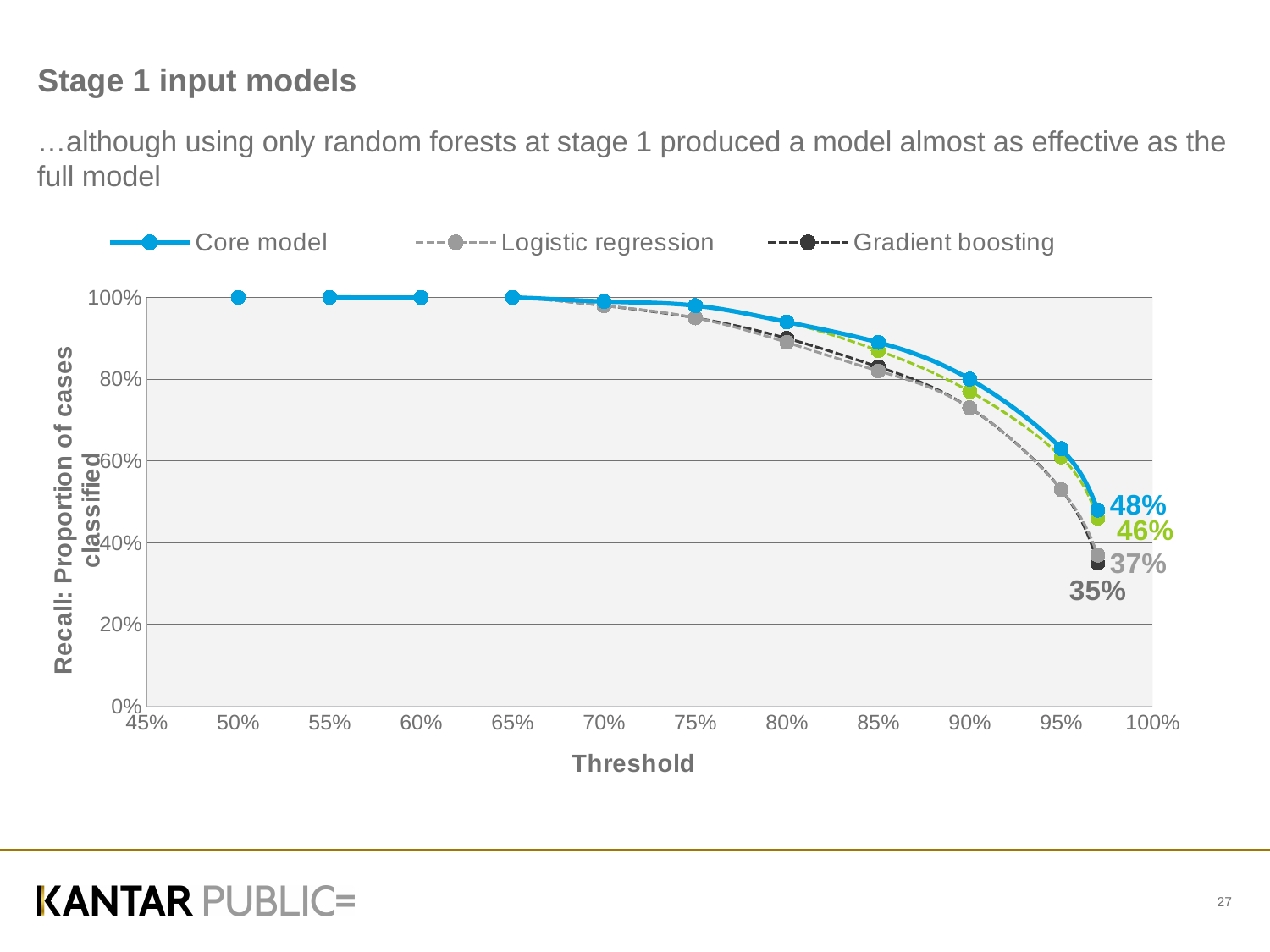
Is the value for Logistic regression at a threshold of 90% greater or less than 80%? less What is the final labelled value for the Core model series? 48% How many series does the legend list? 3 What is the title of the x axis? Threshold What kind of chart is shown on the slide? line chart What is the value of the Core model series at a threshold of 50%? 100% What is the final labelled value for the Logistic regression series? 37% What is the final labelled value for the Gradient boosting series? 35% What is the difference between the final labelled values of the Core model (48%) and Logistic regression (37%)? 11 percentage points Do the recall values rise or fall as the threshold increases along the x axis? fall Which series has the highest labelled value at the right end of the chart? Core model Which series has the lowest labelled value at the right end of the chart? Gradient boosting